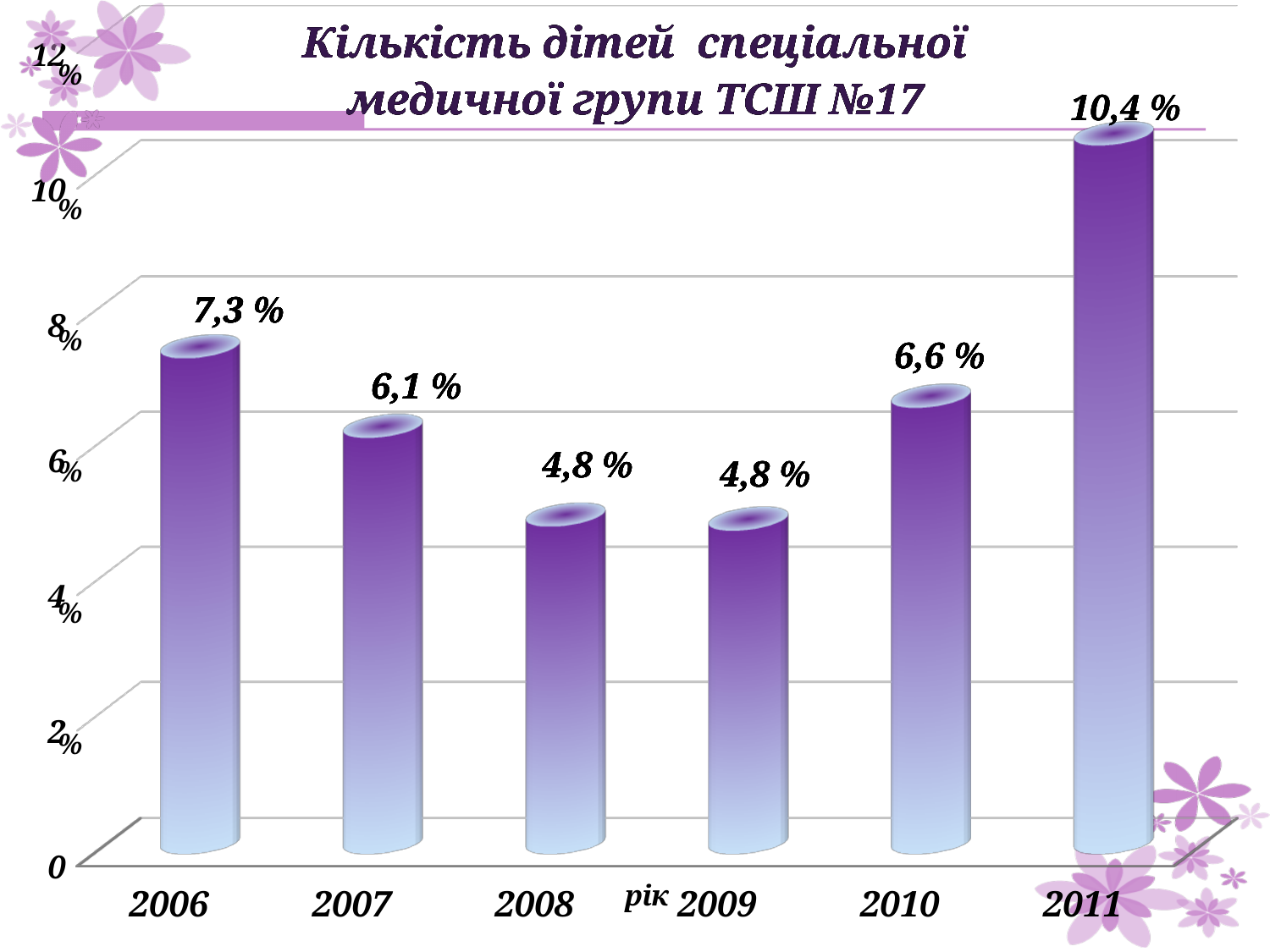
Which is larger, the value for 2007 or the value for 2010? 2010 What is the title of the chart? Кількість дітей спеціальної медичної групи ТСШ №17 Which year has the highest value? 2011 Is the value for 2011 greater or less than 10%? greater What is the value for 2010? 6,6 % Which years share the lowest value? 2008 and 2009 What is the difference between the values for 2007 and 2008? 1,3 % How many years are shown on the x axis? 6 What is the value for 2006? 7,3 % What is the value for 2011? 10,4 % What kind of chart is shown on the slide? bar chart What is the difference between the values for 2011 and 2006? 3,1 %